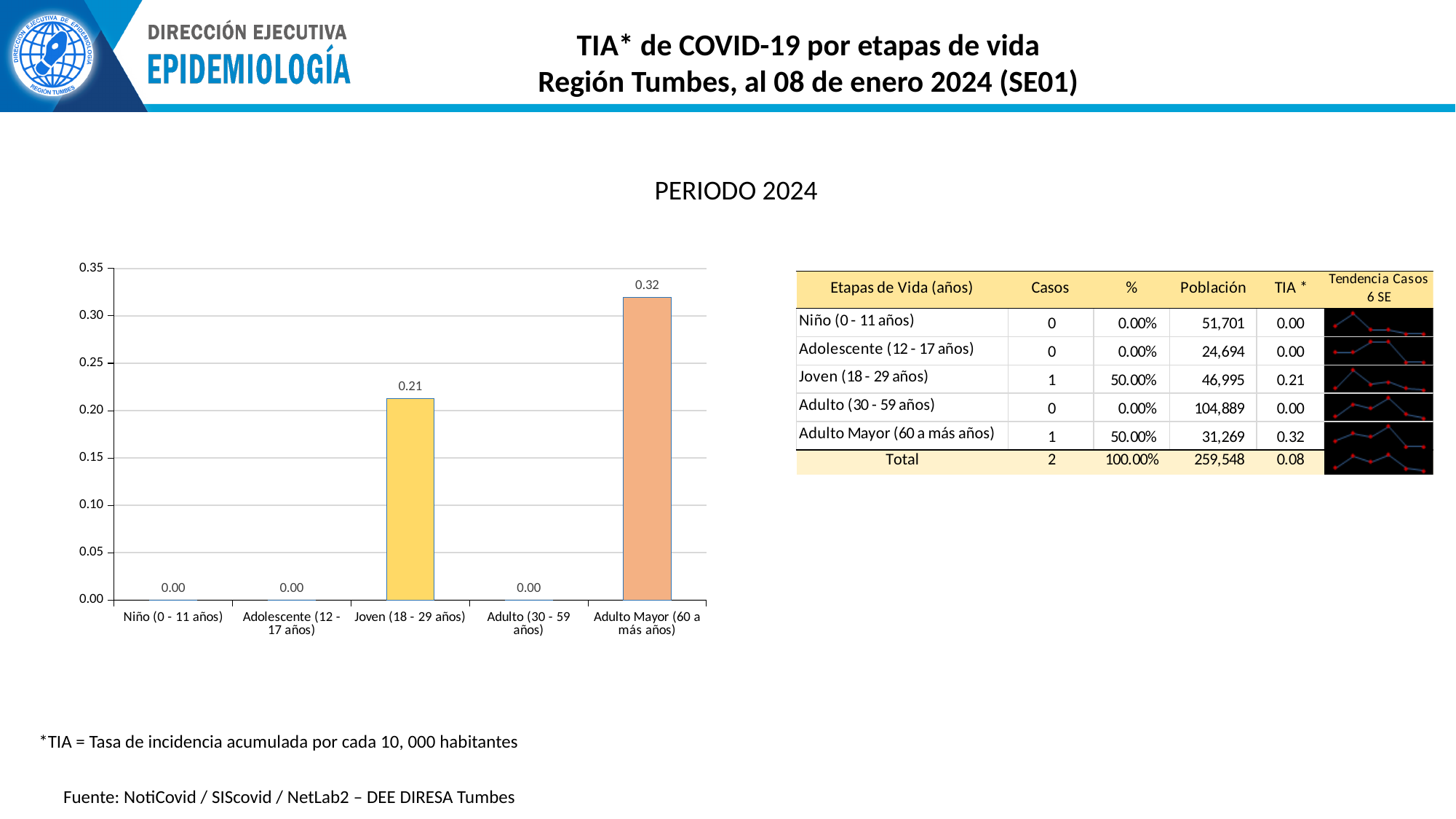
What is the difference between the values for Adulto Mayor (60 a más años) and Joven (18 - 29 años) in the bar chart? 0.11 Which category has the highest value in the bar chart? Adulto Mayor (60 a más años) How many categories in the bar chart have a value of 0.00? 3 What is the title shown above the bar chart? PERIODO 2024 What is the value for Joven (18 - 29 años) in the bar chart? 0.21 Is the value for Adulto Mayor (60 a más años) greater or less than 0.30? greater What is the value for Adulto Mayor (60 a más años) in the bar chart? 0.32 How many categories are shown on the x axis of the bar chart? 5 Is the value for Joven (18 - 29 años) greater or less than 0.25? less Which is larger in the bar chart, the value for Joven (18 - 29 años) or the value for Adulto Mayor (60 a más años)? Adulto Mayor (60 a más años) What is the value for Niño (0 - 11 años) in the bar chart? 0.00 What kind of chart is shown on the slide? bar chart